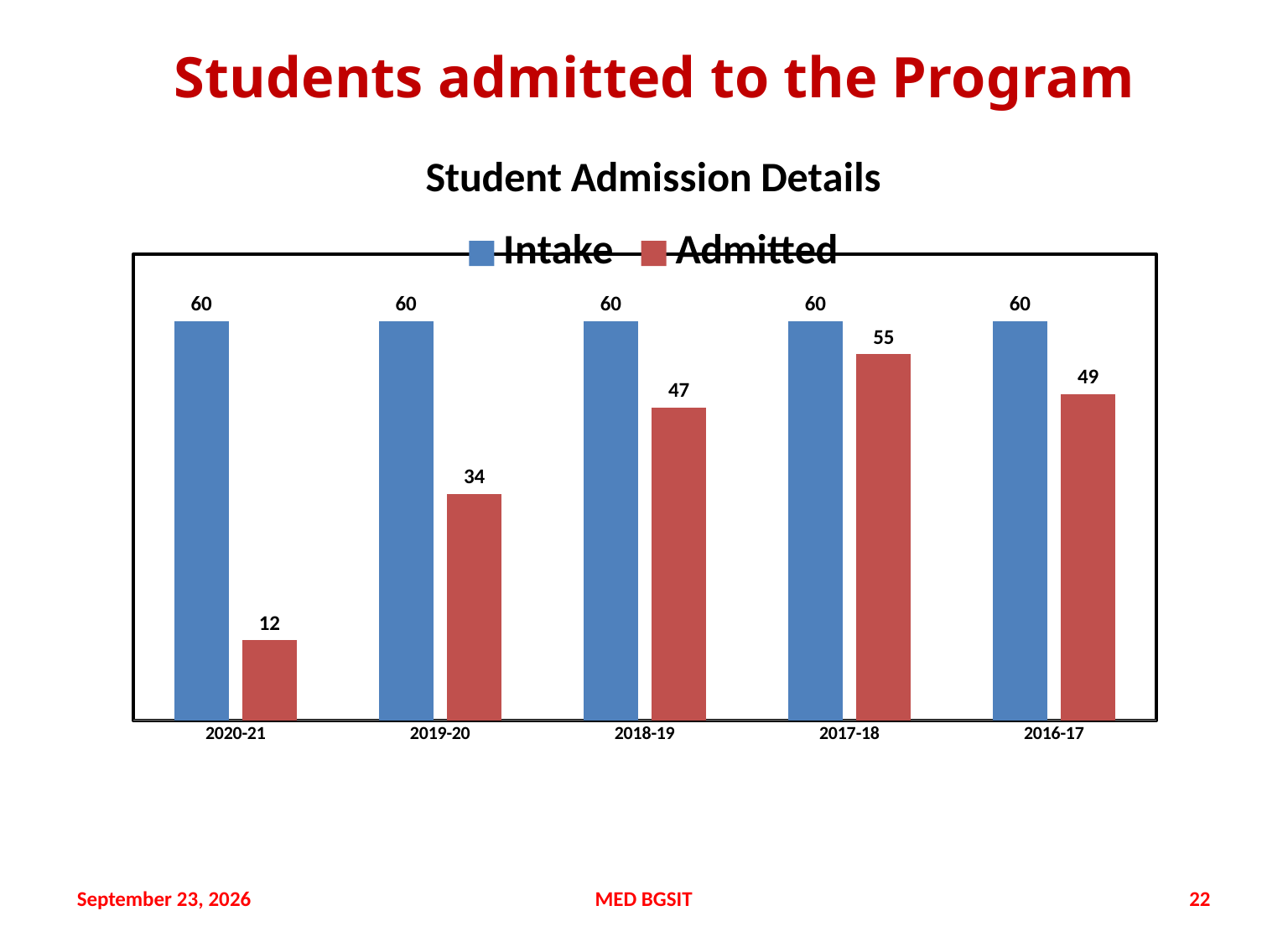
What is the difference between Intake and Admitted for 2019-20? 26 Which is larger, the Admitted value for 2018-19 or for 2016-17? 2016-17 What is the Admitted value for 2017-18? 55 How many years are shown on the x axis? 5 Which year has the highest Admitted value? 2017-18 What is the Intake value for 2018-19? 60 What is the title of the chart? Student Admission Details What kind of chart is shown? Bar chart What is the Admitted value for 2020-21? 12 Which year has the lowest Admitted value? 2020-21 What is the difference between the Admitted values for 2017-18 and 2016-17? 6 How many series does the legend list? 2